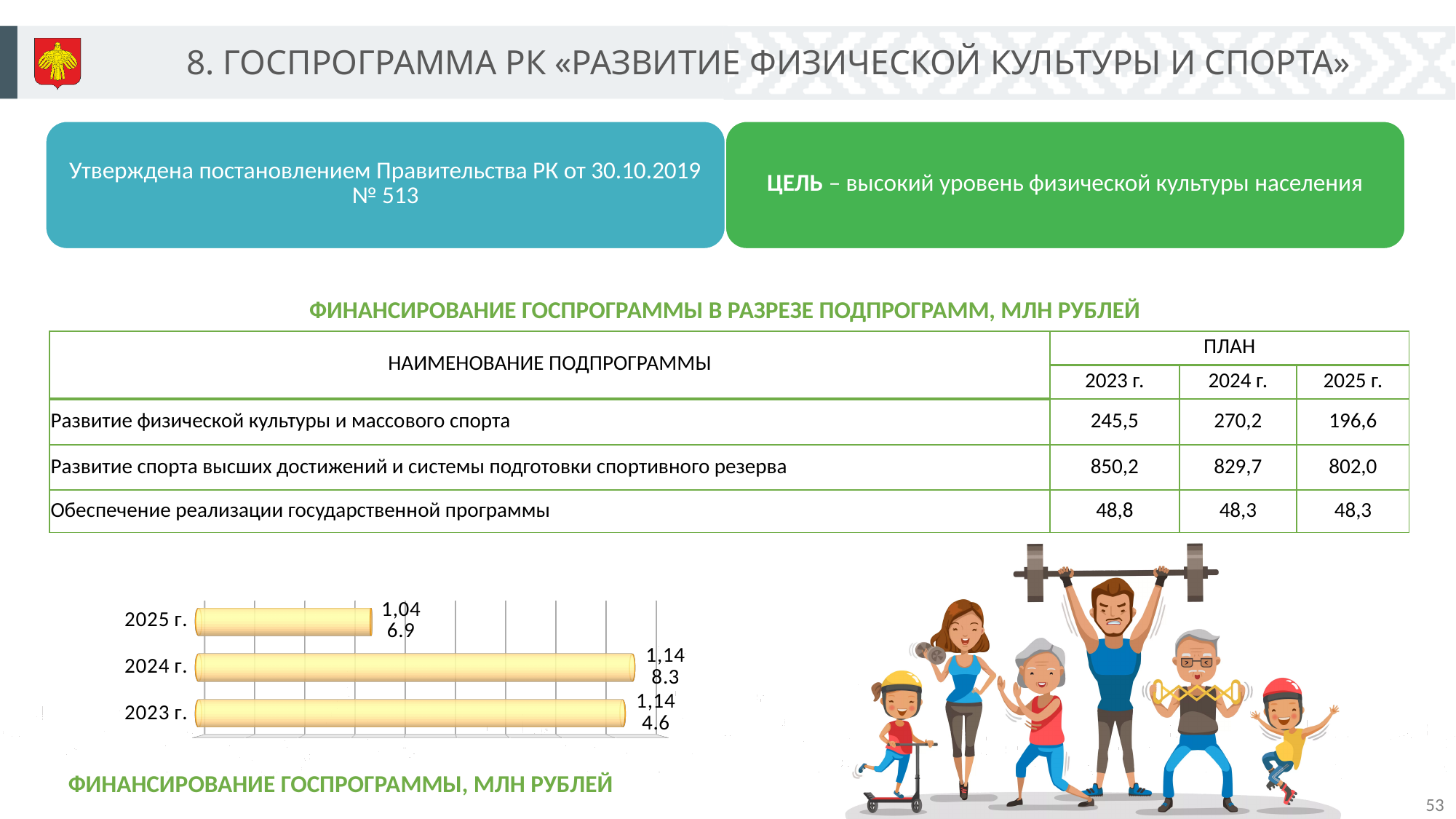
What kind of chart is shown at the bottom left of the slide? bar chart How many years (categories) are plotted in the bar chart at the bottom left? 3 In the bar chart at the bottom left, which bar is longer: 2024 г. or 2025 г.? 2024 г. In the bar chart at the bottom left, does the bar length fall or rise from 2024 г. to 2025 г.? fall What is the title of the bar chart at the bottom left of the slide? ФИНАНСИРОВАНИЕ ГОСПРОГРАММЫ, МЛН РУБЛЕЙ Are the bars in the chart at the bottom left oriented horizontally or vertically? horizontally In the bar chart at the bottom left, which bar is longer: 2023 г. or 2025 г.? 2023 г. Which year is listed at the top of the bar chart at the bottom left? 2025 г. In the bar chart at the bottom left, which year has the shortest bar? 2025 г. In what units are the values of the bar chart at the bottom left expressed, according to its title? млн рублей